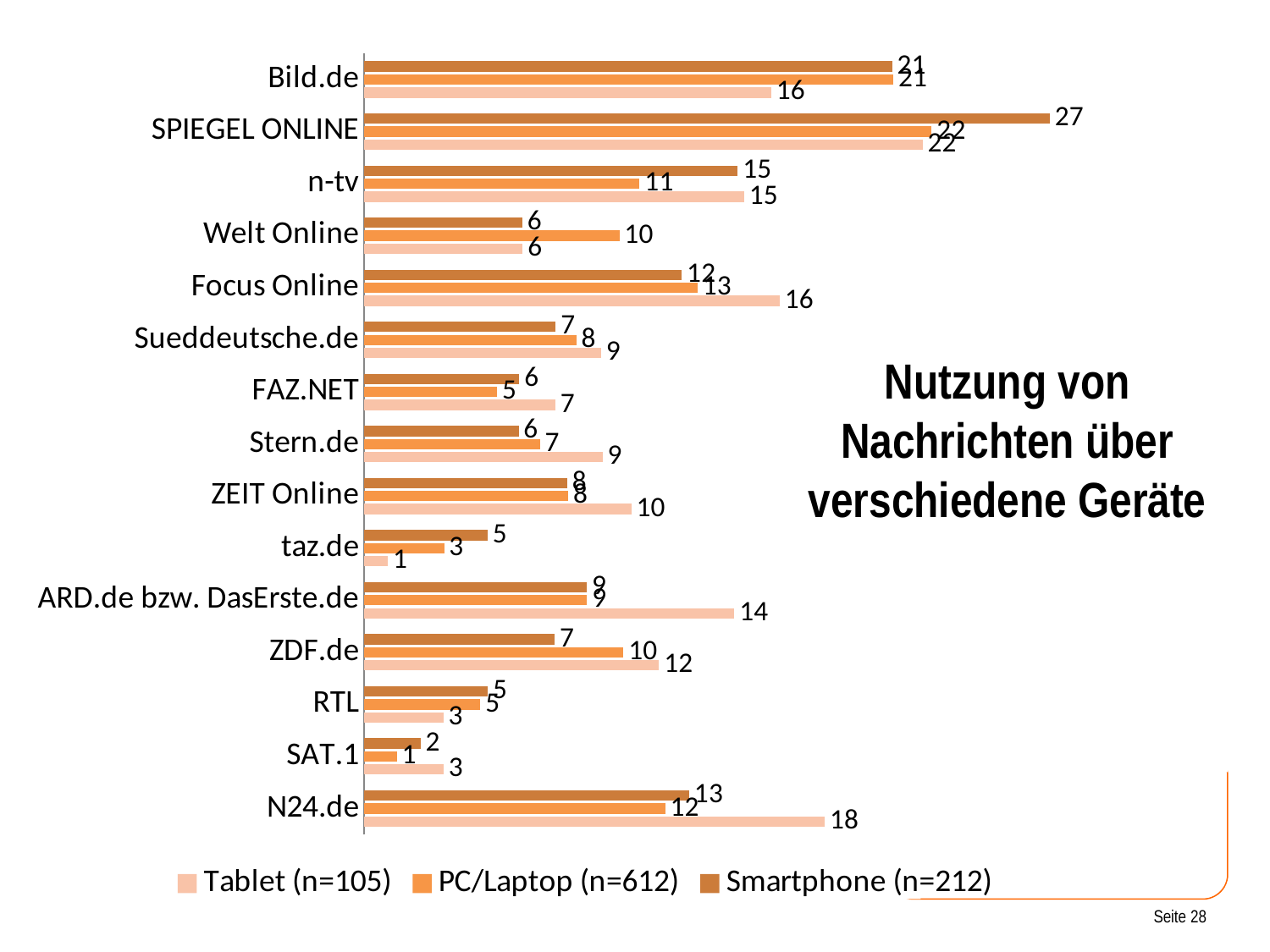
Which category has the lowest Tablet (n=105) value? taz.de How many series does the legend list? 3 How many categories (news sites) are shown on the chart? 15 What is the Tablet (n=105) value for ARD.de bzw. DasErste.de? 14 Which category has the highest Smartphone (n=212) value? SPIEGEL ONLINE For ZDF.de, which is larger: the Tablet (n=105) value or the Smartphone (n=212) value? Tablet (n=105) What is the Smartphone (n=212) value for SPIEGEL ONLINE? 27 What is the Tablet (n=105) value for N24.de? 18 What is the difference between the Tablet (n=105) and Smartphone (n=212) values for Focus Online? 4 What is the PC/Laptop (n=612) value for Welt Online? 10 What kind of chart is shown on the slide? Bar chart What is the title of the chart? Nutzung von Nachrichten über verschiedene Geräte